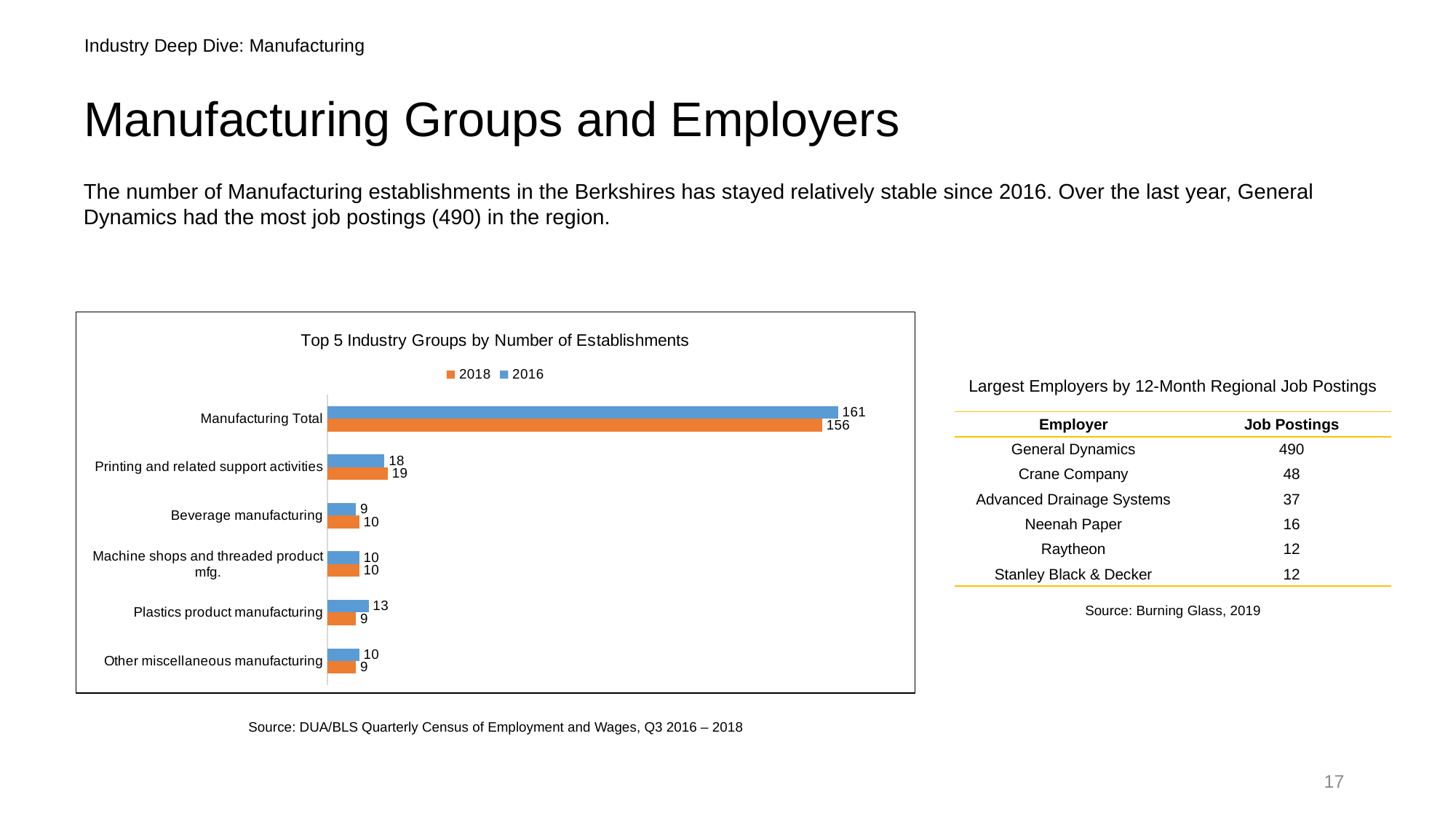
What is the 2018 value for Manufacturing Total? 156 What is the 2018 value for Printing and related support activities? 19 Which is larger for Plastics product manufacturing, the 2016 value or the 2018 value? 2016 What is the 2016 value for Plastics product manufacturing? 13 What type of chart is shown on the slide? bar chart How many series does the chart's legend list? 2 What is the difference between the 2016 and 2018 values for Manufacturing Total? 5 What is the title of the chart? Top 5 Industry Groups by Number of Establishments How many categories are plotted on the chart? 6 What is the 2016 value for Manufacturing Total? 161 Excluding Manufacturing Total, which category has the highest 2016 value? Printing and related support activities What is the difference between the 2016 and 2018 values for Plastics product manufacturing? 4